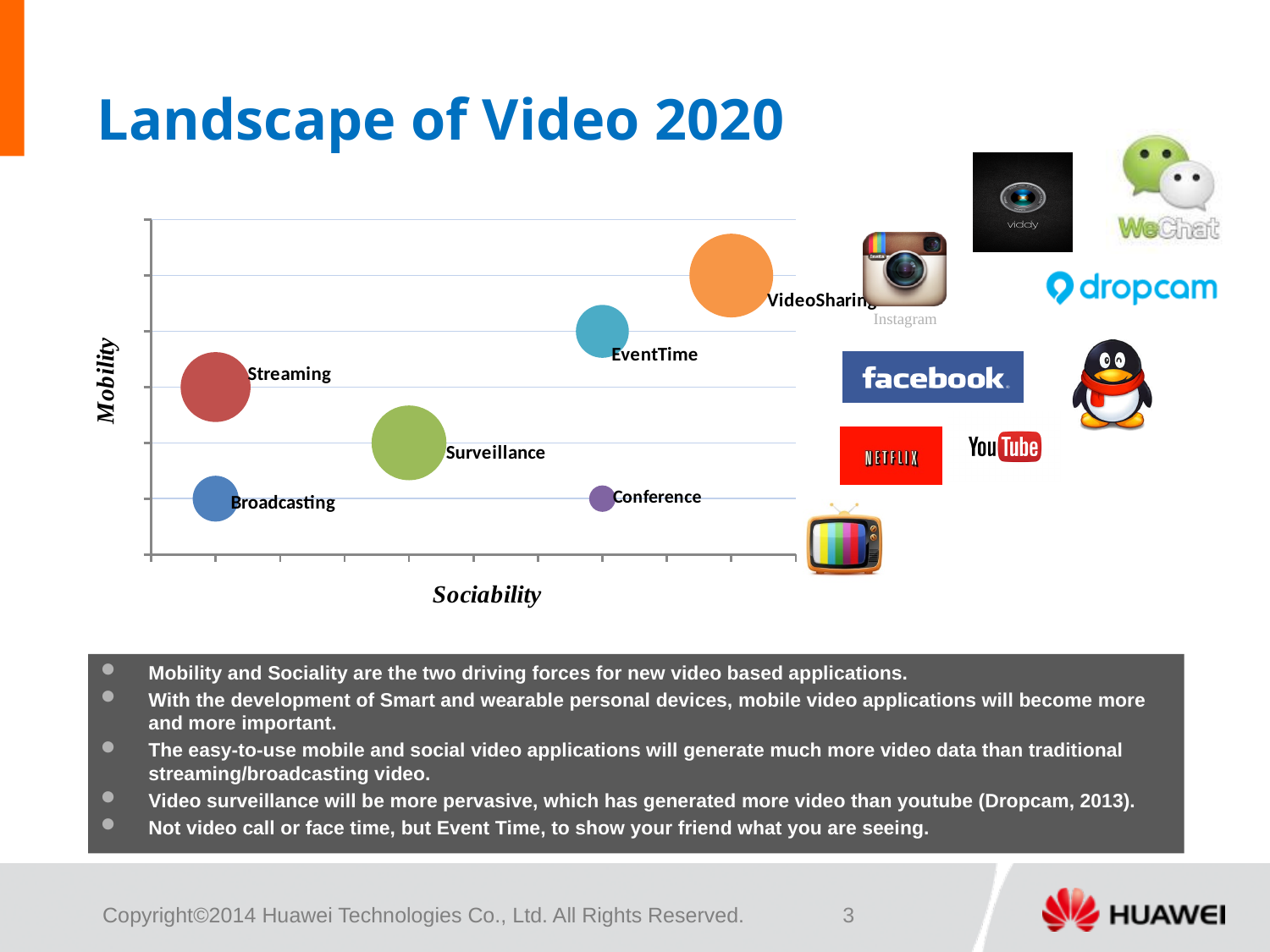
What is the label of the vertical axis of the chart? Mobility Which has higher Mobility, Streaming or Surveillance? Streaming Which has higher Sociability, EventTime or Surveillance? EventTime How many bubbles (categories) are plotted in the chart? 6 Which category is represented by the largest bubble? VideoSharing Which has higher Sociability, Surveillance or Streaming? Surveillance Which category is represented by the smallest bubble? Conference Which category has the highest Sociability in the chart? VideoSharing What kind of chart is shown on the slide? bubble chart Which category has the highest Mobility in the chart? VideoSharing What is the label of the horizontal axis of the chart? Sociability